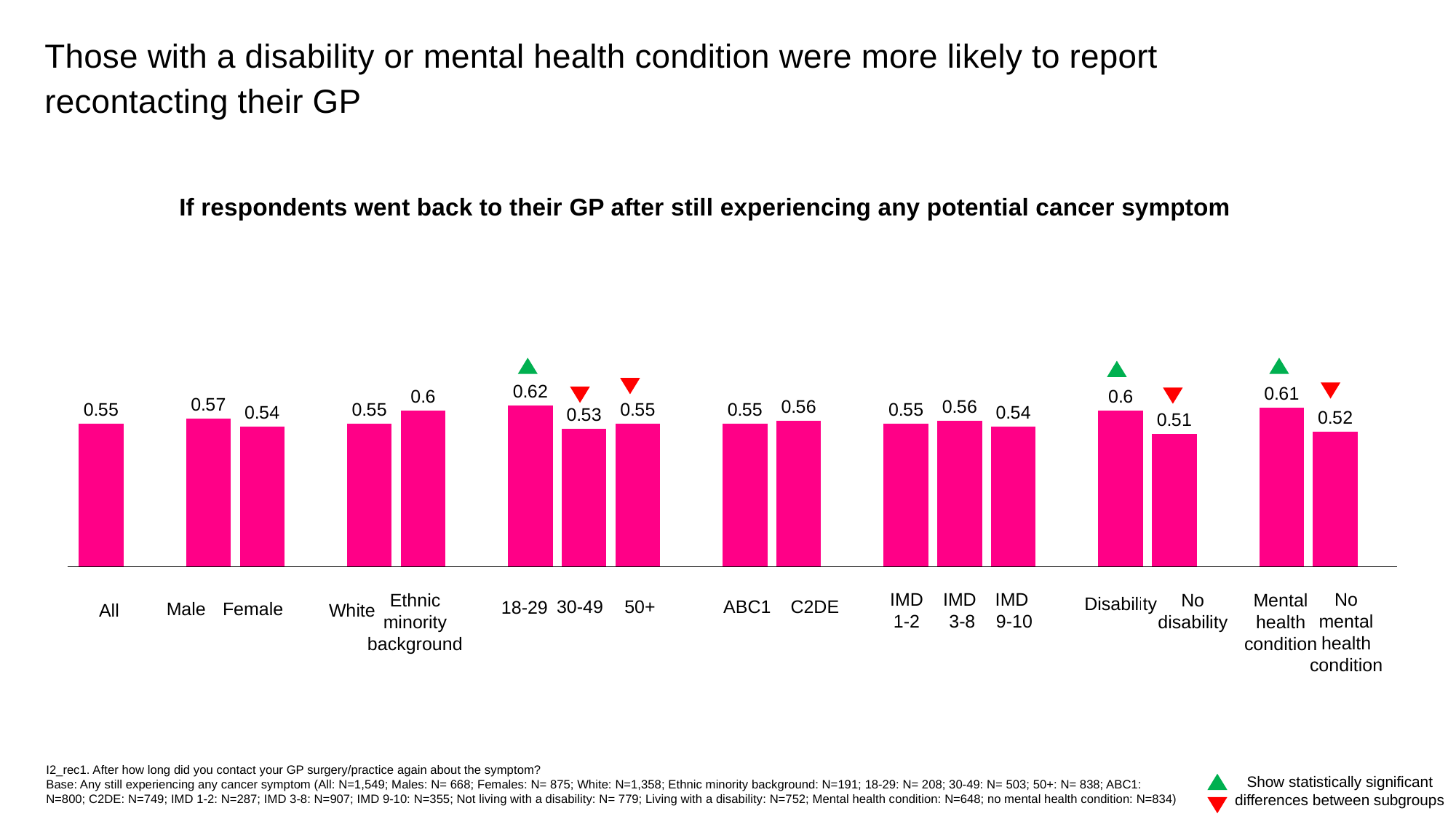
How many bars are plotted on the chart? 17 What is the value for 'Ethnic minority background'? 0.6 What is the difference between the values for Male and Female? 0.03 Which category has the lowest value? No disability What is the difference between 'Mental health condition' and 'No mental health condition'? 0.09 What is the value for 'No disability'? 0.51 What kind of chart is shown on the slide? Bar chart What is the title of the chart? If respondents went back to their GP after still experiencing any potential cancer symptom What is the value for the 18-29 age group? 0.62 What is the value for the 'All' category? 0.55 Which is larger, the value for Disability or the value for No disability? Disability Which category has the highest value? 18-29